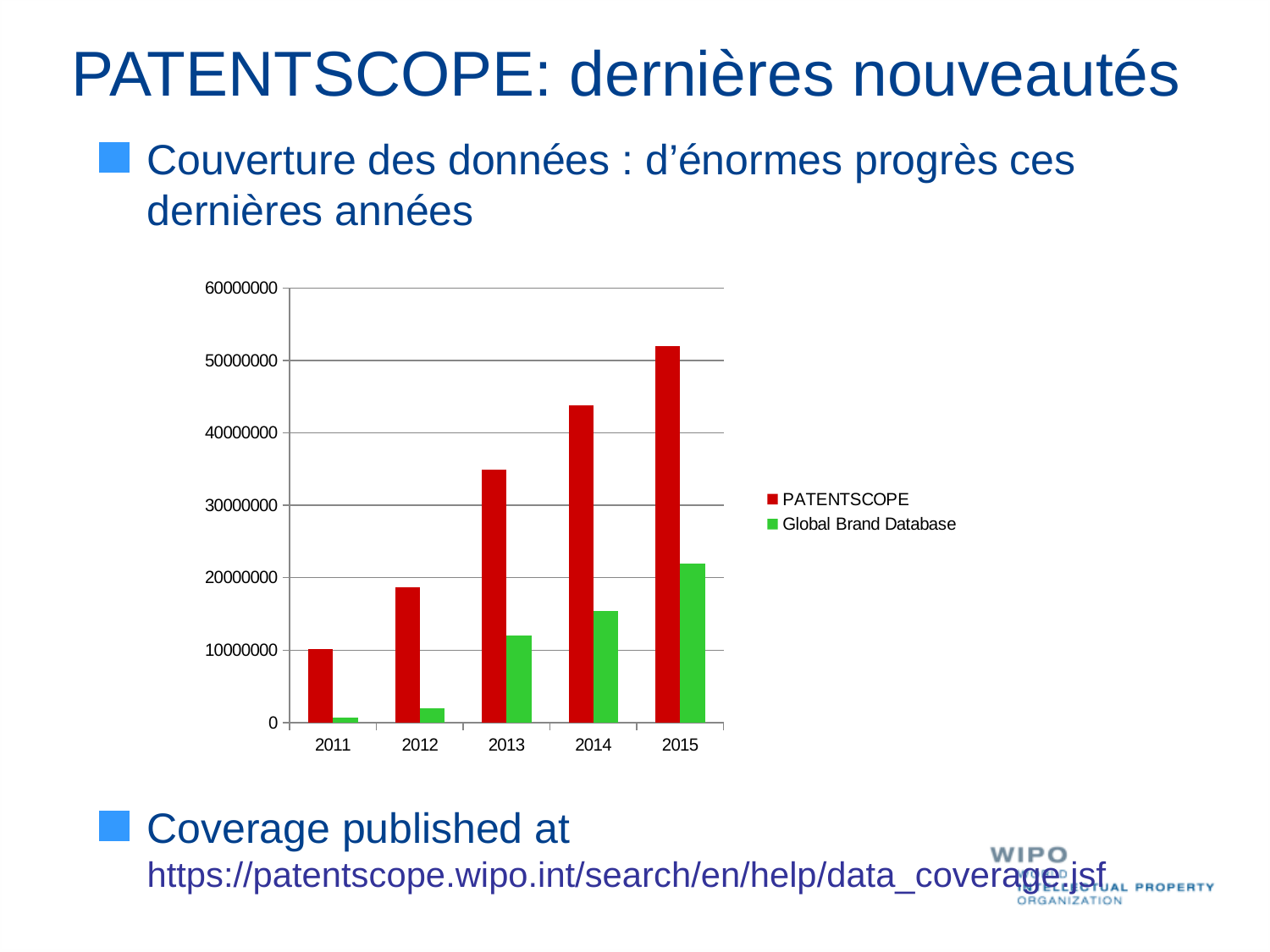
Is the Global Brand Database value for 2013 greater or less than 10000000? greater Is the PATENTSCOPE value for 2015 greater or less than 50000000? greater How many years are shown on the x axis of the chart? 5 Which colour represents the Global Brand Database series in the chart? green Is the PATENTSCOPE value for 2012 greater or less than 20000000? less How many series does the chart's legend list? 2 Which year has the highest PATENTSCOPE value? 2015 In 2014, which series has the larger value, PATENTSCOPE or Global Brand Database? PATENTSCOPE Which year has the lowest Global Brand Database value? 2011 Do the PATENTSCOPE values rise or fall from 2011 to 2015? rise What kind of chart is shown on the slide? bar chart